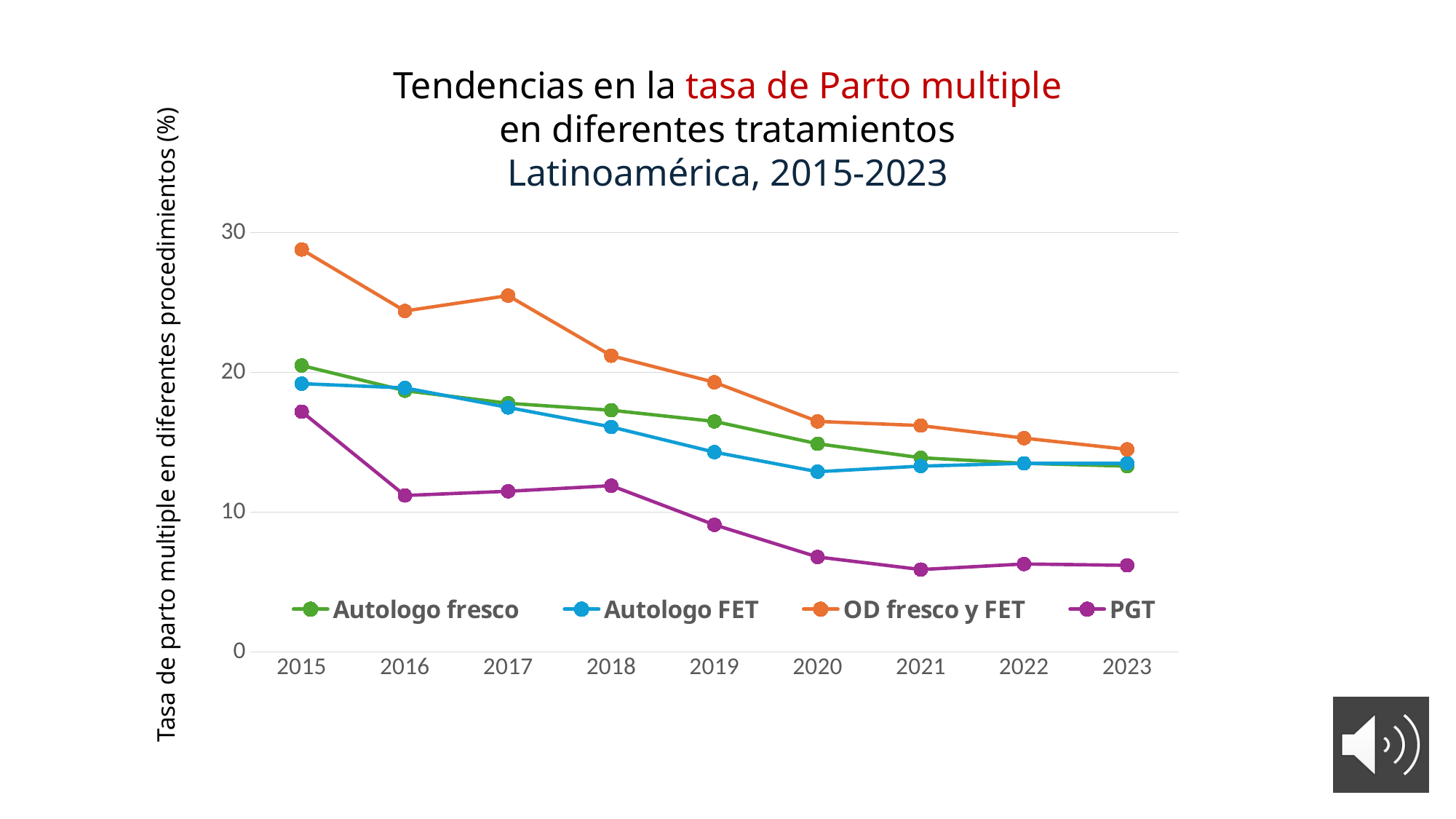
Which is larger in 2023, the value for Autologo fresco or the value for PGT? Autologo fresco Which series has the lowest value in 2023? PGT What is the label of the y axis? Tasa de parto multiple en diferentes procedimientos (%) How many series does the legend list? 4 Is the value for Autologo FET in 2020 greater or less than 20? less How many years are plotted along the x axis? 9 In which year does the OD fresco y FET series reach its highest value? 2015 Is the value for OD fresco y FET in 2015 greater or less than 20? greater Which series has the highest value in 2015? OD fresco y FET What kind of chart is shown on the slide? line chart Does the OD fresco y FET series rise or fall overall from 2015 to 2023? fall Is the value for PGT in 2023 greater or less than 10? less